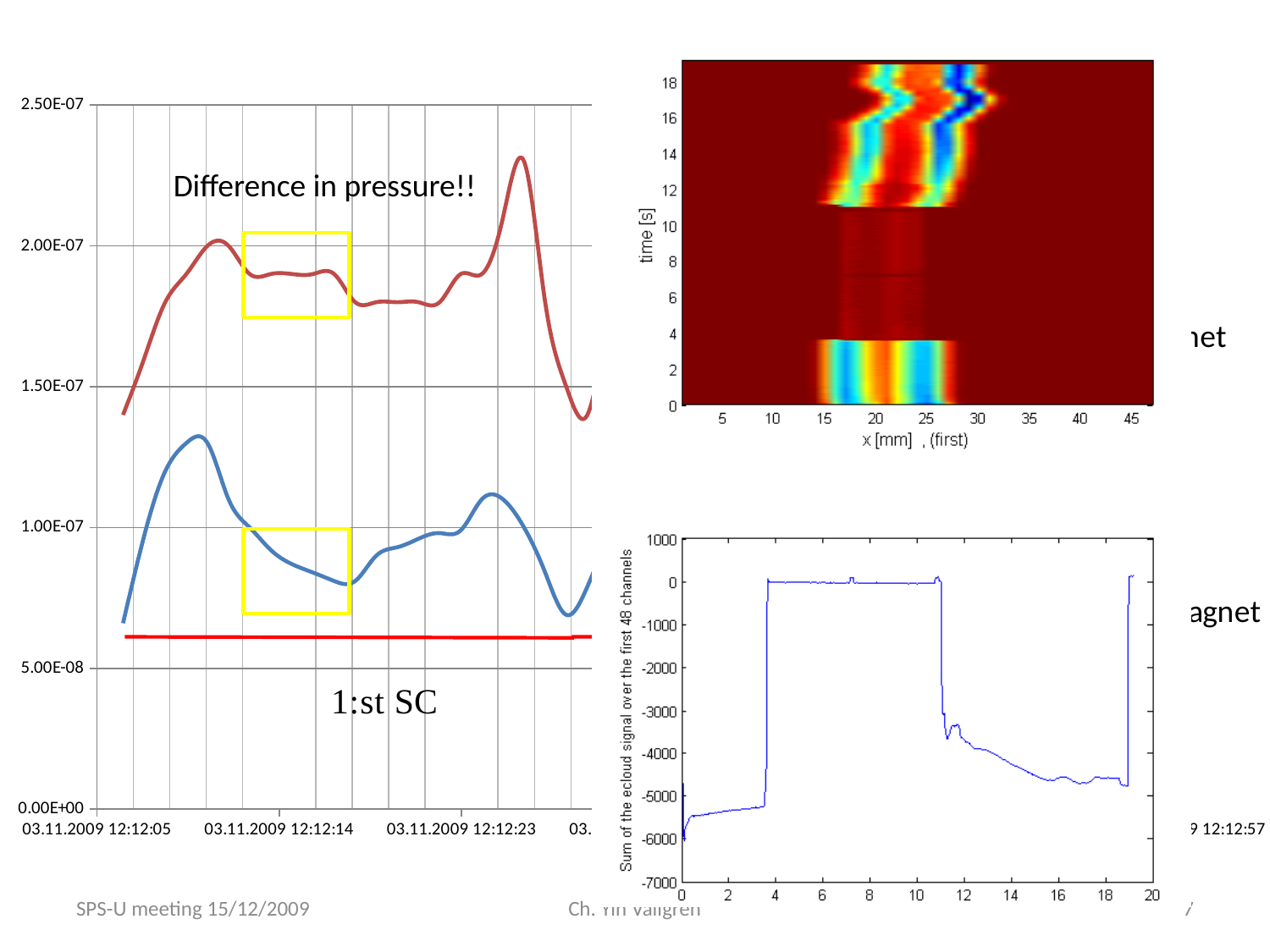
What kind of chart is the bottom-right chart on the slide? line chart In the bottom-right chart, is the value at x = 8 greater or less than -1000? greater In the left chart, how many lines are plotted? 3 What kind of chart is the large chart on the left of the slide? line chart What is the highest value shown on the y axis of the left chart? 2.50E-07 In the bottom-right chart, is the value at x = 2 greater or less than -5000? less What annotation text is written above the curves in the left chart? Difference in pressure!! In the bottom-right chart, is the value at x = 16 greater or less than -4000? less In the left chart, which line is higher throughout: the dark red curve or the blue curve? the dark red curve